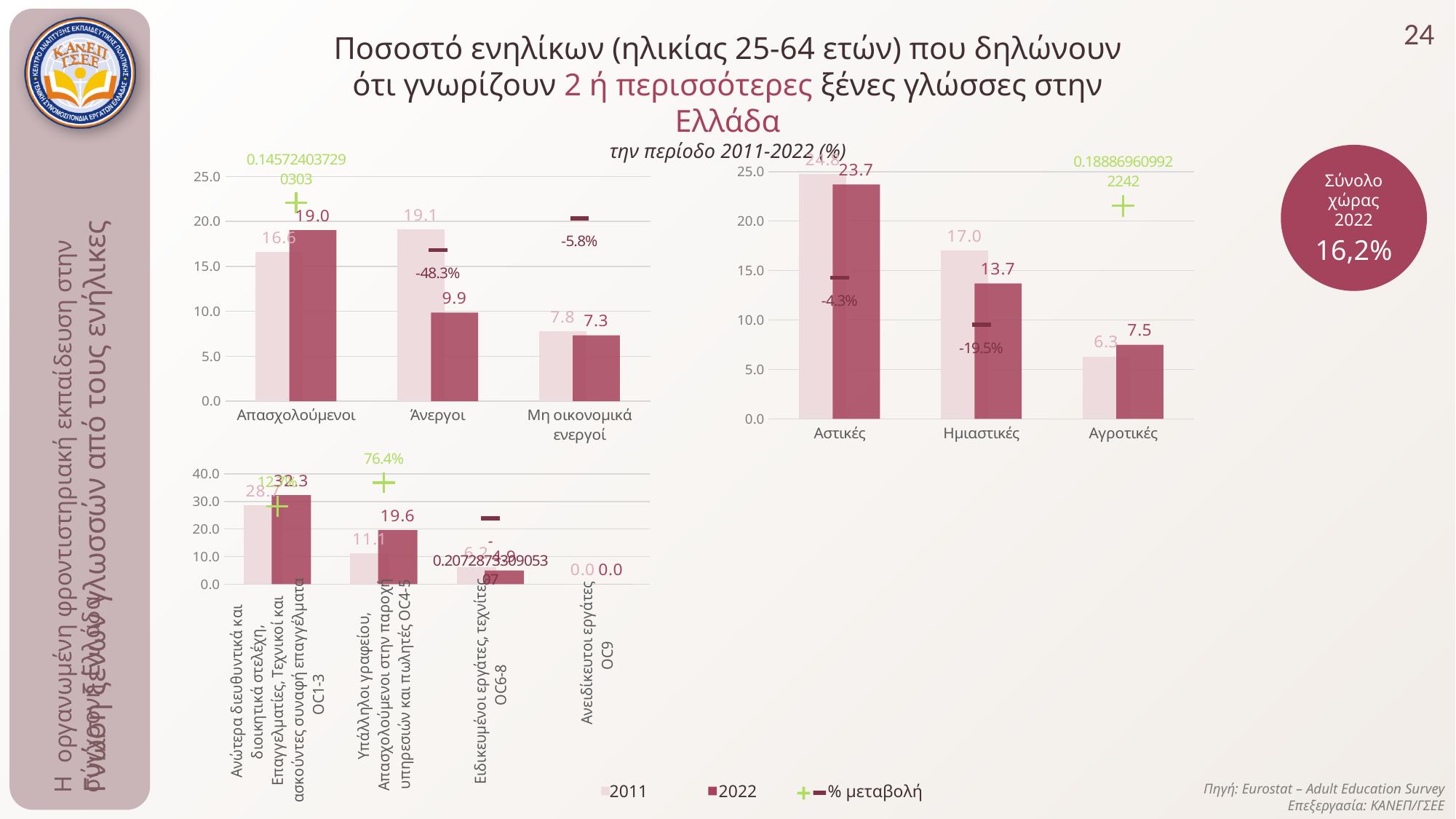
In the top-left chart, what is the 2011 value for Απασχολούμενοι? 16.6 In the top-right chart, is the 2022 value for Αστικές greater or less than 20.0? greater What value is shown in the circle labelled Σύνολο χώρας 2022? 16,2% In the top-right chart, what is the percentage change shown for Ημιαστικές? -19.5% In the bottom-left chart, what is the percentage change shown for OC4-5? 76.4% In the top-left chart, what is the 2022 value for Άνεργοι? 9.9 In the bottom-left chart, what is the 2022 value for Υπάλληλοι γραφείου, Απασχολούμενοι στην παροχή υπηρεσιών και πωλητές OC4-5? 19.6 In the top-left chart, what is the percentage change shown for Άνεργοι? -48.3% In the top-right chart, what is the 2022 value for Ημιαστικές? 13.7 How many entries does the legend at the bottom of the slide list? 3 In the top-right chart, which category has the lowest 2022 value? Αγροτικές In the top-left chart, what is the difference between the 2011 and 2022 values for Μη οικονομικά ενεργοί? 0.5